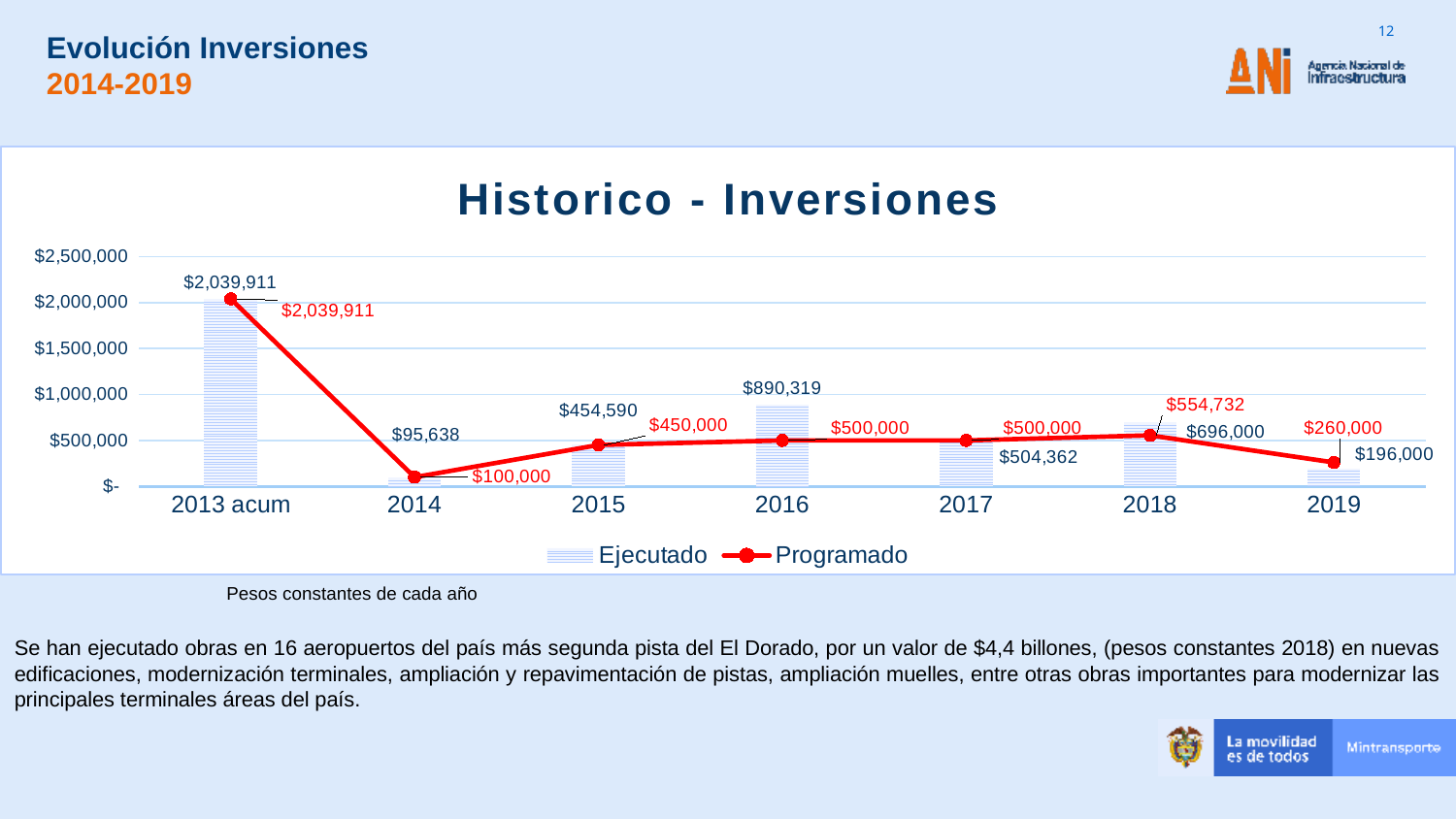
What is the Ejecutado value for 2016? $890,319 What type of chart is shown on the slide? Combination bar and line chart What is the Programado value for 2014? $100,000 What is the difference between the Ejecutado and Programado values for 2016? $390,319 What is the Ejecutado value for 2014? $95,638 How many series does the legend of the 'Historico - Inversiones' chart list? 2 Which category has the lowest Ejecutado value? 2014 Which category has the highest Ejecutado value? 2013 acum What is the Programado value for 2019? $260,000 In 2017, which is larger: the Ejecutado value or the Programado value? Ejecutado What are the two series named in the chart legend? Ejecutado and Programado How many categories are shown on the x axis of the chart? 7